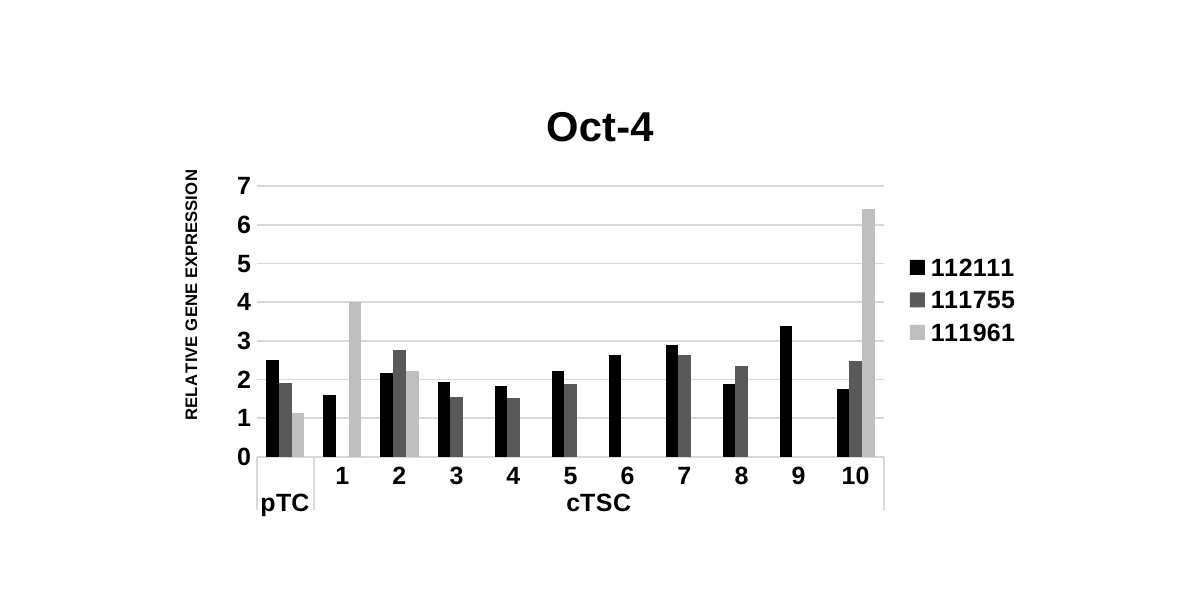
At pTC, which series has the larger value, 112111 or 111961? 112111 How many categories are shown along the x axis? 11 What kind of chart is shown on the slide? bar chart What is the title of the chart? Oct-4 Is the value for series 112111 at category 9 greater or less than 3? greater Which category has the highest bar for series 111961? 10 How many series does the legend list? 3 Is the value for series 111961 at pTC greater or less than 2? less Which category has the highest bar for series 112111? 9 Is the value for series 111961 at category 10 greater or less than 6? greater At category 2, which series has the larger value, 112111 or 111755? 111755